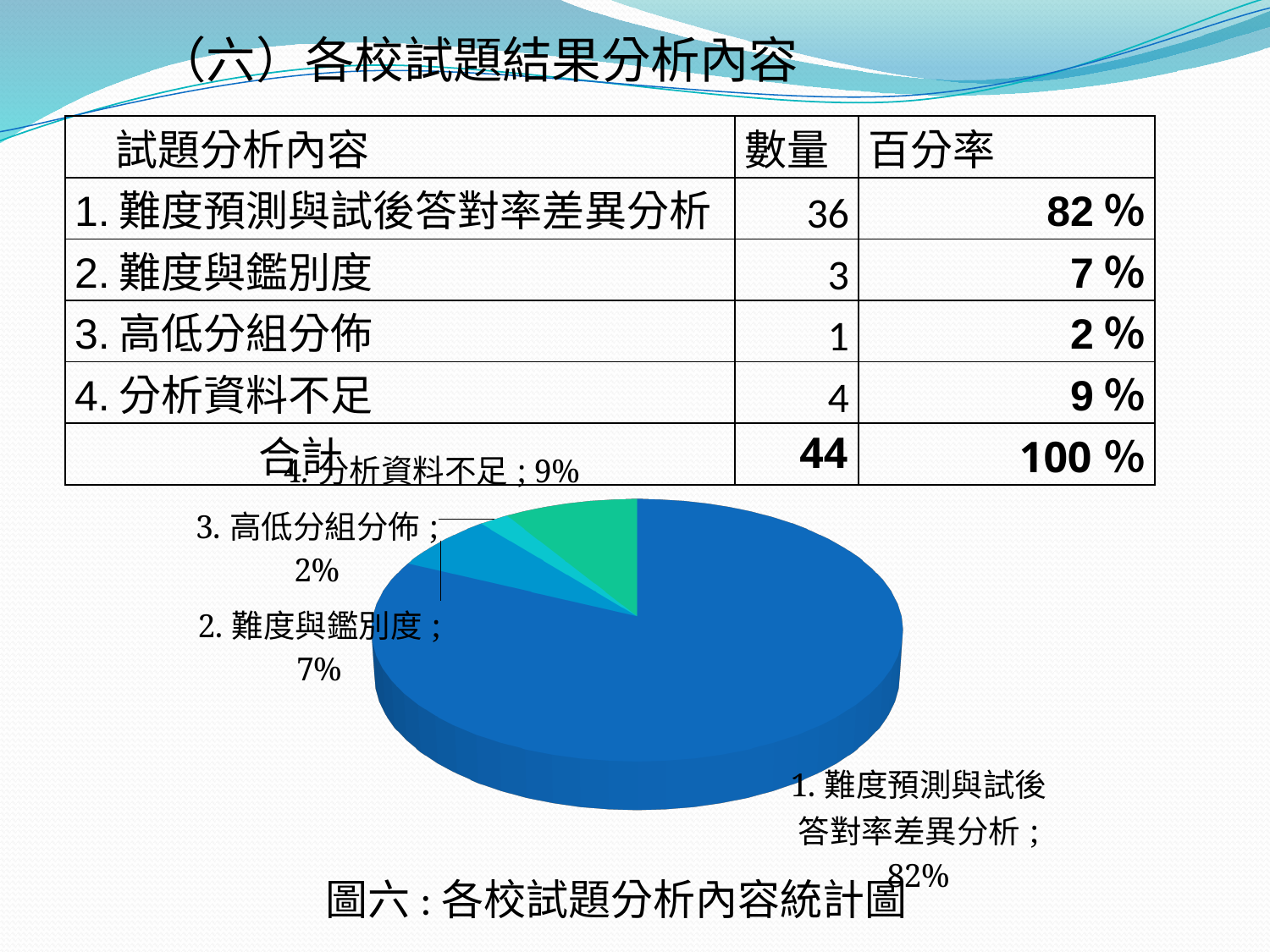
What share of the pie does 2. 難度與鑑別度 have? 7% What share of the pie does 4. 分析資料不足 have? 9% How many slices does the pie chart have? 4 Which slice of the pie chart is the largest? 1. 難度預測與試後答對率差異分析 What share of the pie does 1. 難度預測與試後答對率差異分析 have? 82% Which is larger in the pie chart, 4. 分析資料不足 or 2. 難度與鑑別度? 4. 分析資料不足 What is the difference in percentage points between the 4. 分析資料不足 slice and the 2. 難度與鑑別度 slice? 2% What kind of chart is shown on the slide? pie chart What is the difference in percentage points between the 1. 難度預測與試後答對率差異分析 slice and the 4. 分析資料不足 slice? 73% What is the caption printed below the pie chart? 圖六：各校試題分析內容統計圖 Which slice of the pie chart is the smallest? 3. 高低分組分佈